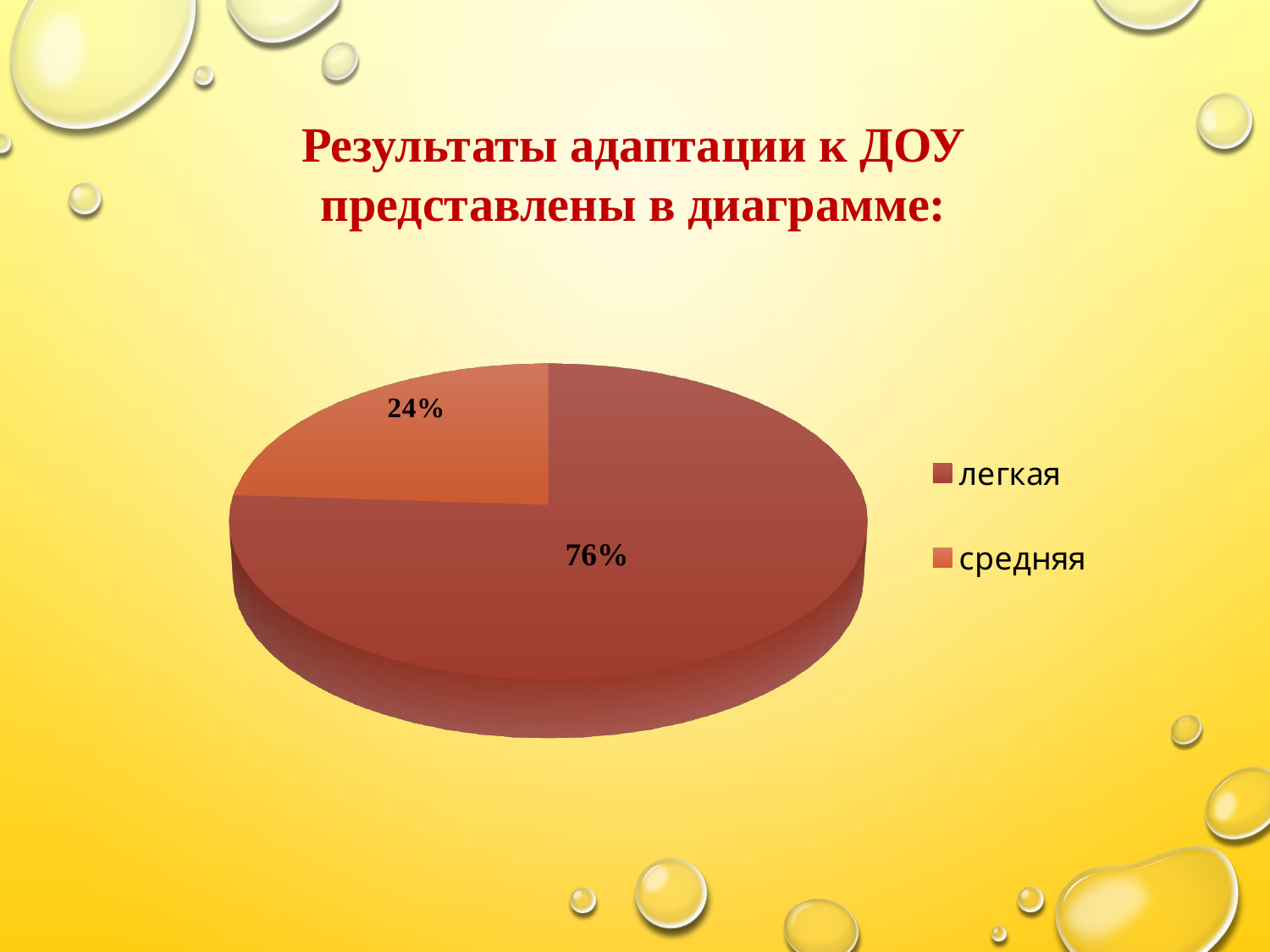
What kind of chart is shown on the slide? pie chart What percentage of the pie is labelled "средняя"? 24% What percentage of the pie is labelled "легкая"? 76% How many entries does the legend list? 2 How many slices does the pie chart have? 2 Which category has the largest share of the pie? легкая Which category has the smallest share of the pie? средняя Which colour represents "средняя" in the legend? orange What is the title text above the chart? Результаты адаптации к ДОУ представлены в диаграмме: What is the total of the two percentages shown on the pie? 100% Which slice is larger, "легкая" or "средняя"? легкая What is the difference in percentage points between the "легкая" and "средняя" slices? 52